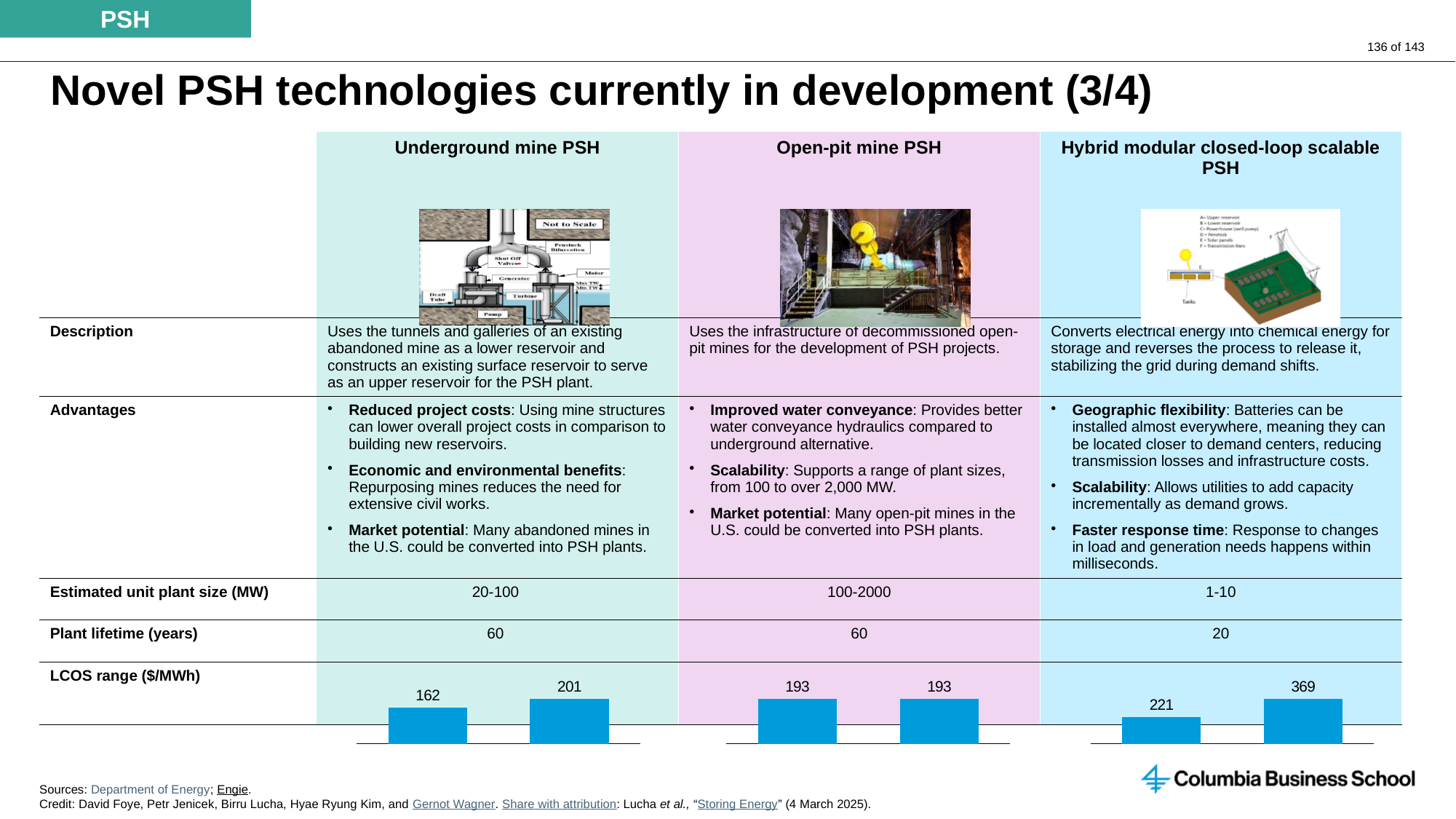
What type of chart is used to show the LCOS range for each technology? bar chart Across the three LCOS range charts, which technology has the highest single bar value? Hybrid modular closed-loop scalable PSH In the LCOS range chart under Underground mine PSH, what is the difference between the right bar and the left bar? 39 In the LCOS range chart under Open-pit mine PSH, what value is shown on the left bar? 193 In the LCOS range chart under Hybrid modular closed-loop scalable PSH, what is the value of the right bar? 369 In the LCOS range chart under Underground mine PSH, what is the value of the right bar? 201 Across the three LCOS range charts, which technology has the lowest single bar value? Underground mine PSH In the LCOS range chart under Underground mine PSH, what is the value of the left bar? 162 In the LCOS range chart under Underground mine PSH, which bar is larger, the left or the right? right In the LCOS range chart under Hybrid modular closed-loop scalable PSH, what is the difference between the two bars? 148 In the LCOS range chart under Hybrid modular closed-loop scalable PSH, what is the value of the left bar? 221 How many bars are in the LCOS range chart under Open-pit mine PSH? 2